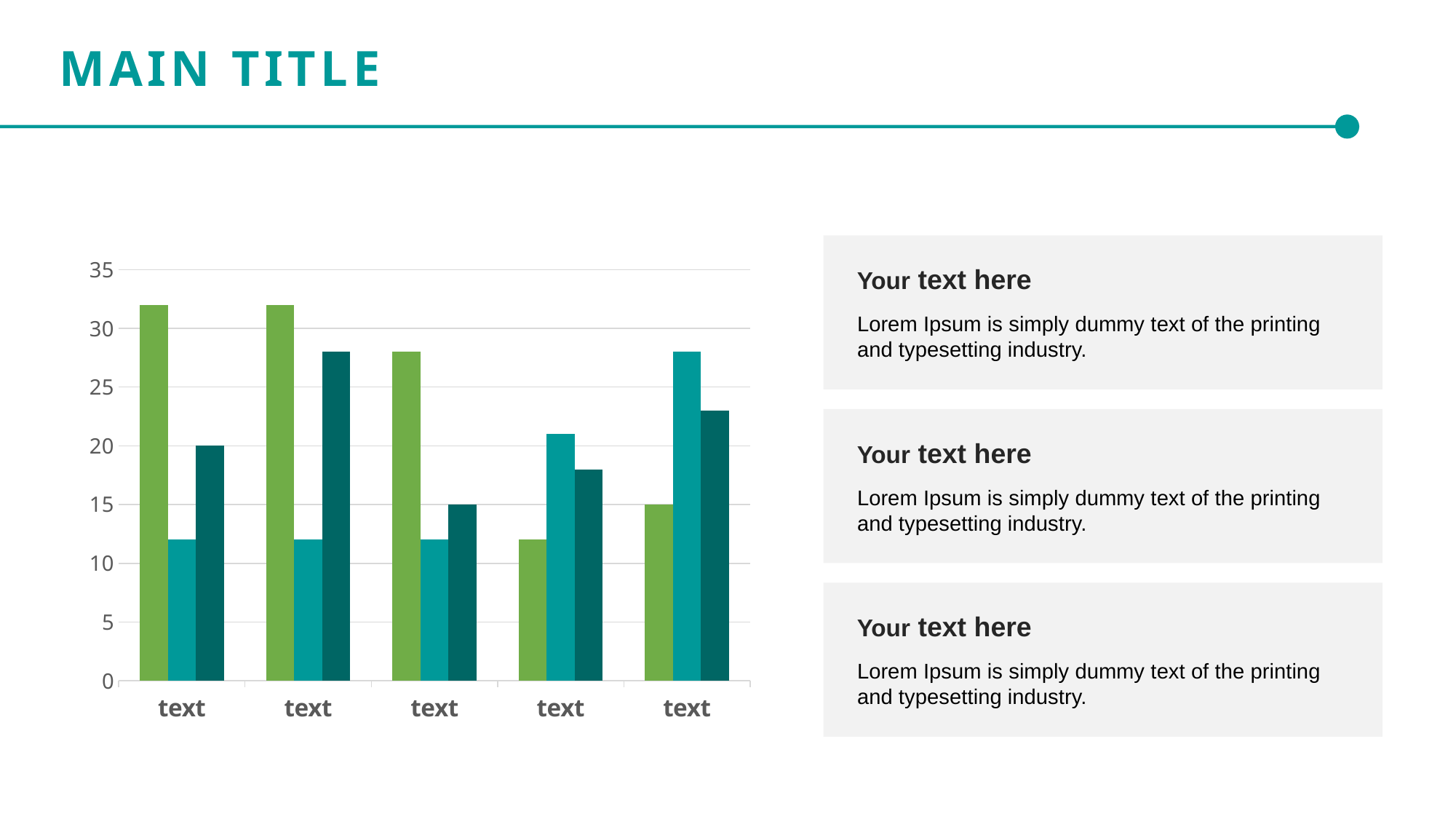
Do the teal bars rise or fall from the first category to the fifth category? rise What kind of chart is shown on the slide? bar chart Is the value of the light green bar in the first category greater or less than 30? greater What is the title of the slide containing the chart? MAIN TITLE Is the value of the dark green bar in the second category greater or less than 25? greater Is the value of the teal bar in the fifth category greater or less than 25? greater Which bar is the shortest in the fifth category: light green, teal or dark green? light green How many bars are plotted for each category in the chart? 3 How many categories are shown along the x axis of the chart? 5 Which bar is the tallest in the first category: light green, teal or dark green? light green Which is larger in the fourth category, the teal bar or the dark green bar? the teal bar